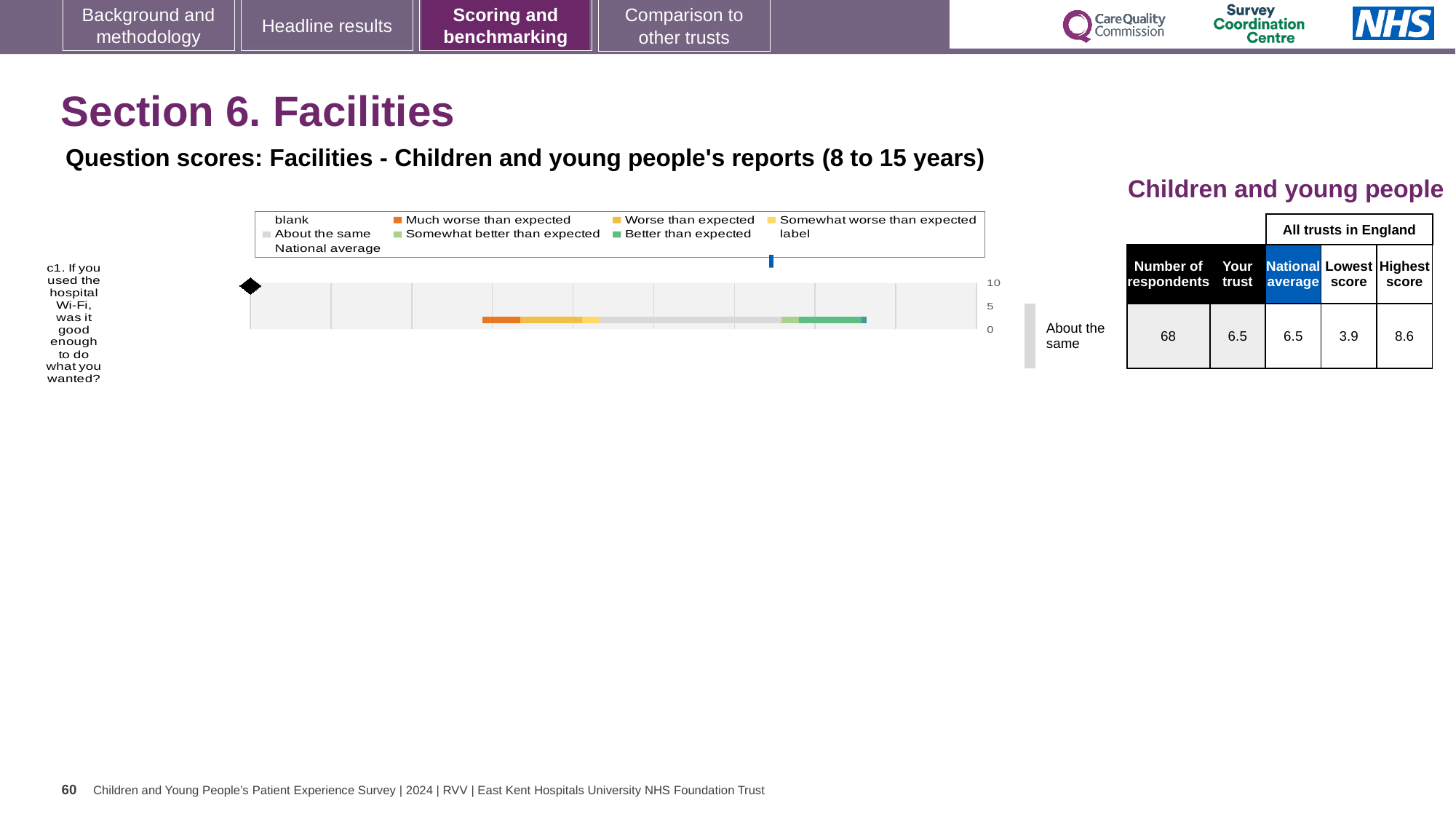
What kind of chart is shown on the slide? bar chart How many respondents answered question c1? 68 In the chart legend, which colour represents 'Much worse than expected'? orange What is the national average score for question c1 in the table next to the chart? 6.5 What is the difference between the highest score and the lowest score for question c1? 4.7 Which survey question is plotted in the chart? c1. If you used the hospital Wi-Fi, was it good enough to do what you wanted? Is the trust's score for question c1 larger than, smaller than, or equal to the national average? equal What is the 'Your trust' score for question c1 in the table next to the chart? 6.5 What is the lowest score among all trusts in England for question c1? 3.9 How many survey questions are plotted in the chart? 1 What is the highest score among all trusts in England for question c1? 8.6 What benchmark category is the trust's result for question c1 assigned to? About the same